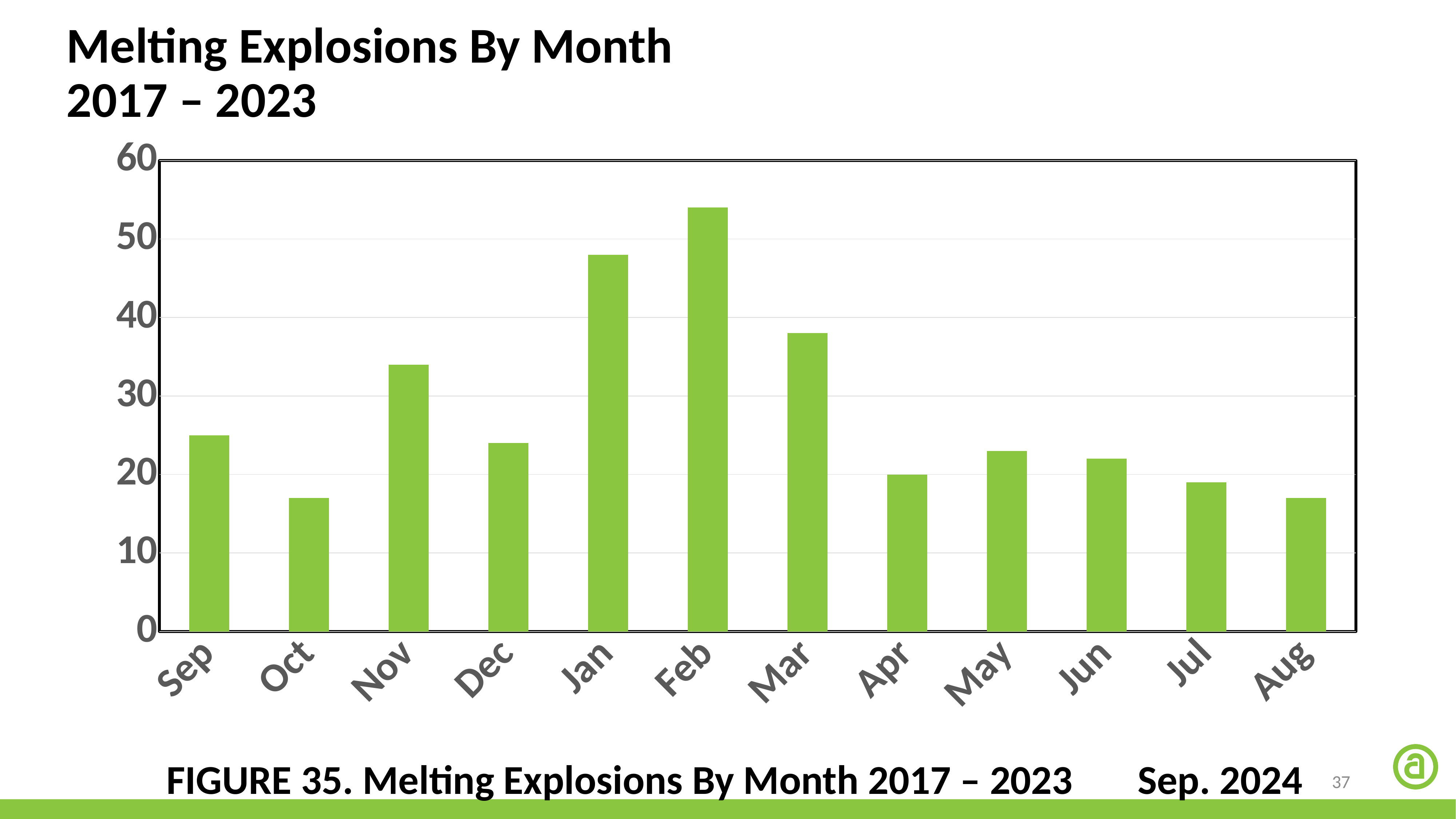
Is the value for Feb greater or less than 50? greater What is the title of the chart? Melting Explosions By Month 2017 – 2023 Which month has the highest number of melting explosions? Feb What kind of chart is shown on the slide? bar chart Which is larger, the value for Nov or the value for Dec? Nov Is the value for Mar greater or less than 40? less Is the value for Oct greater or less than 20? less How many months are plotted on the x axis? 12 Does the value rise or fall from Jan to Feb? rise Which is larger, the value for Jan or the value for Mar? Jan